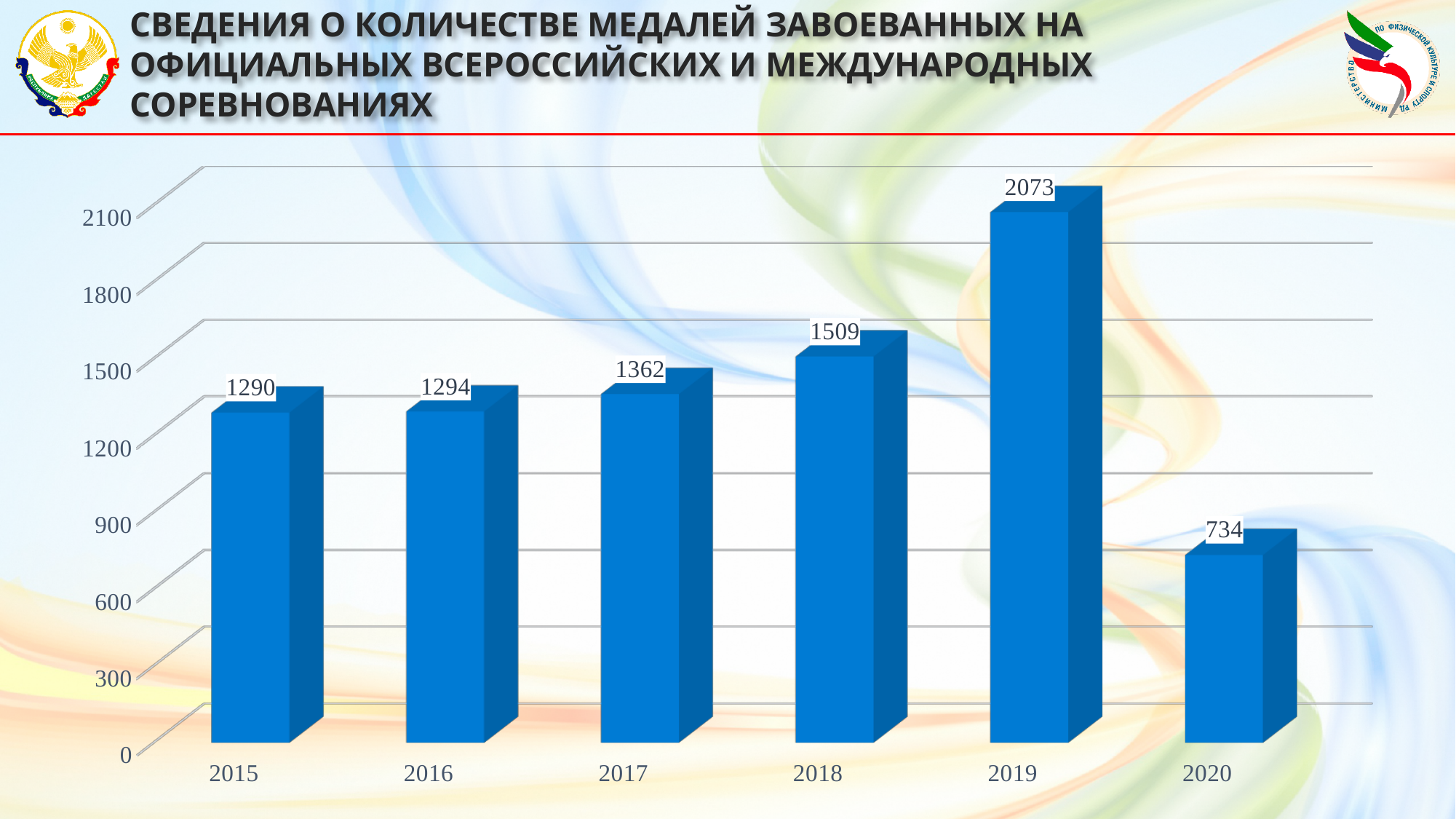
Which year has the highest number of medals? 2019 Do the values rise or fall from 2015 to 2019? rise Which is larger, the value for 2017 or the value for 2018? 2018 What is the difference between the values for 2016 and 2015? 4 What is the number of medals shown for 2017? 1362 Which year has the lowest number of medals? 2020 What is the difference between the values for 2019 and 2018? 564 What kind of chart is shown on the slide? bar chart How many years are shown on the x axis? 6 Is the value for 2020 greater or less than 900? less What is the number of medals shown for 2020? 734 What is the number of medals shown for 2018? 1509